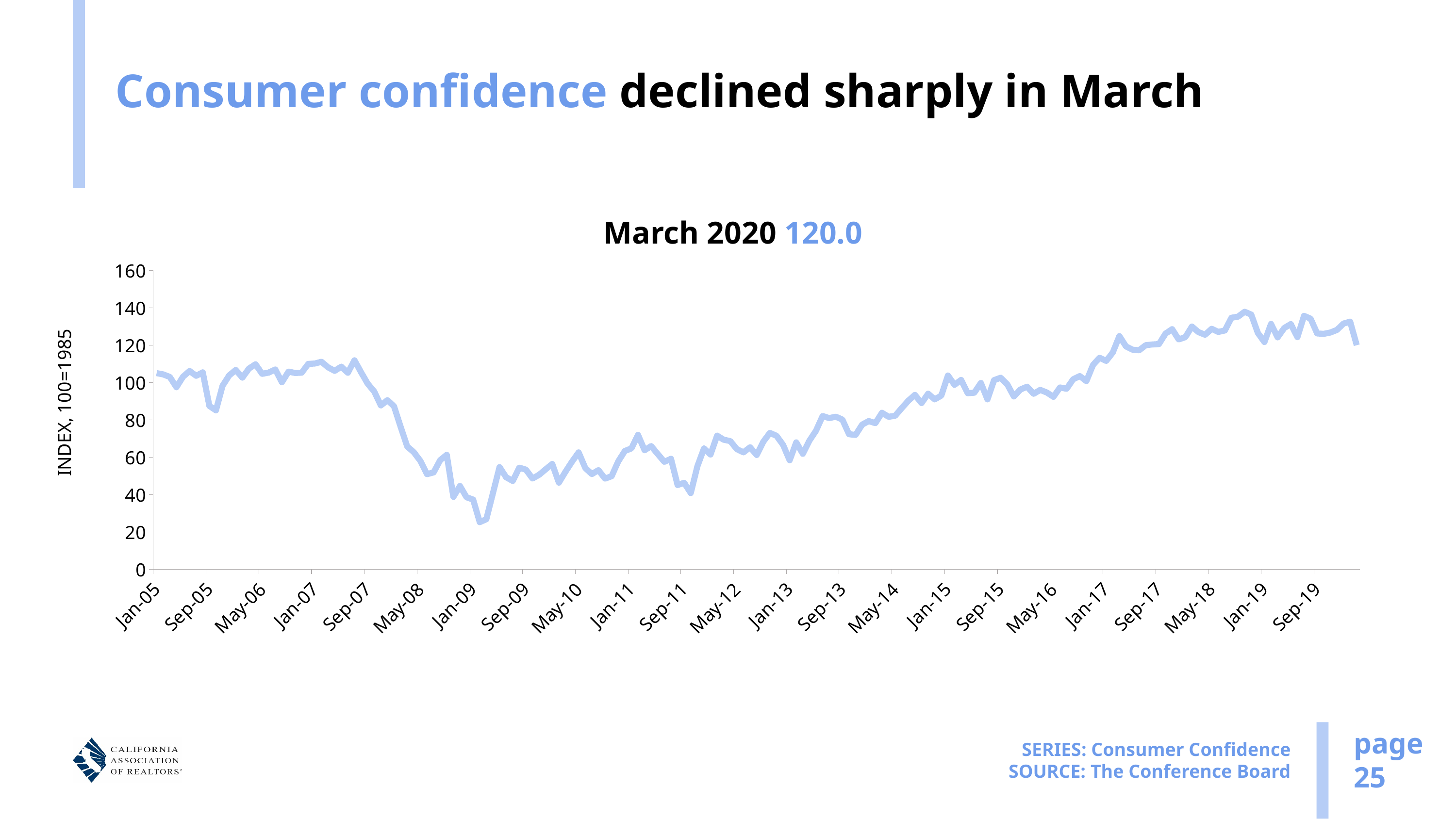
Is the value at Jan-09 greater or less than 60? less Is the value at Sep-19 greater or less than 100? greater What is the consumer confidence index value for March 2020 shown on the slide? 120.0 Is the value at May-08 greater or less than 80? less Which is larger, the value at Jan-05 or the value at Jan-09? Jan-05 Does the line generally rise or fall between Jan-07 and Jan-09? fall What is the label on the vertical axis of the chart? INDEX, 100=1985 In which year does the line reach its lowest point? 2009 What kind of chart is shown on the slide? line chart Does the line generally rise or fall between Jan-09 and Sep-19? rise